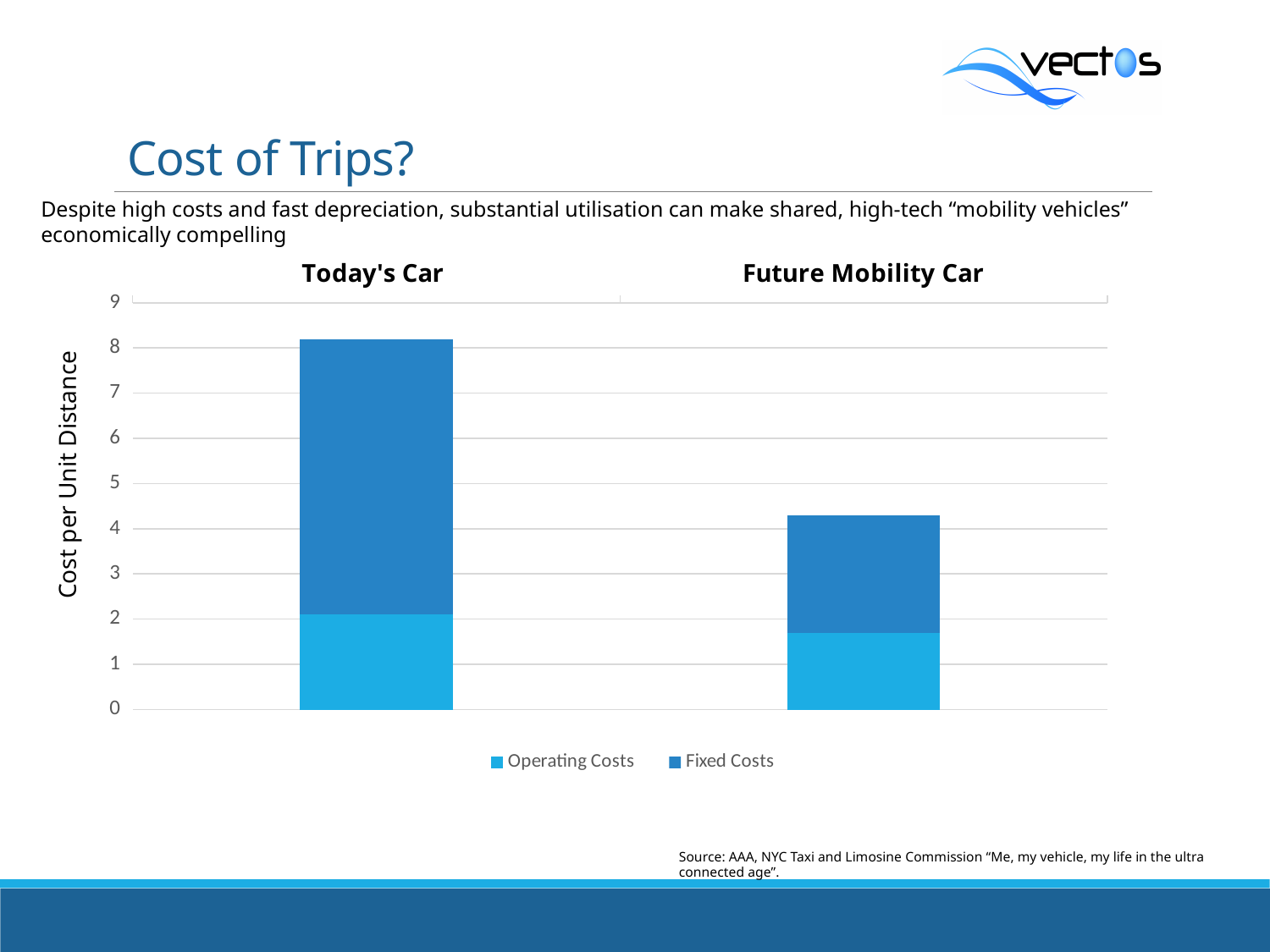
How many series does the chart's legend list? 2 What kind of chart is shown on the slide? stacked bar chart What is the label on the vertical axis of the chart? Cost per Unit Distance Is the total bar for Future Mobility Car greater or less than 5? less Which category has the higher total bar, Today's Car or Future Mobility Car? Today's Car How many categories are shown on the x axis of the chart? 2 Which category has the lowest total cost per unit distance? Future Mobility Car What are the two series listed in the chart's legend? Operating Costs and Fixed Costs Is the Operating Costs value for Future Mobility Car greater or less than 2? less Which category has the larger Fixed Costs segment, Today's Car or Future Mobility Car? Today's Car Is the total bar for Today's Car greater or less than 7? greater